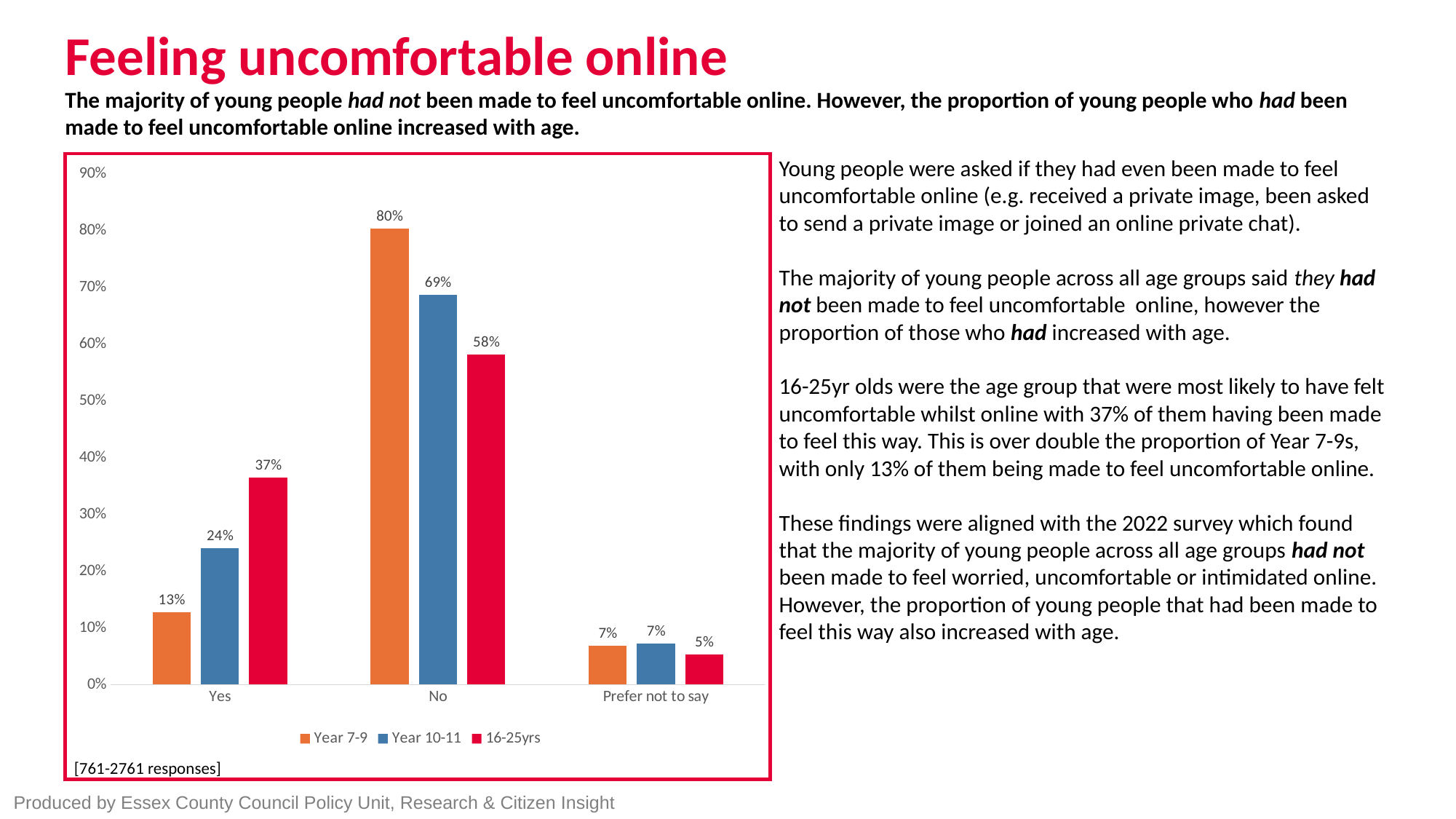
How many series does the legend list? 3 What kind of chart is shown on the slide? Bar chart Which age group has the highest value for 'Yes'? 16-25yrs What percentage of Year 10-11 respondents answered 'Prefer not to say'? 7% What percentage of Year 7-9 respondents answered 'Yes'? 13% Which is larger: the Year 10-11 value for 'No' or the Year 7-9 value for 'No'? Year 7-9 Is the Year 10-11 value for 'Yes' greater or less than 20%? greater Which colour represents the 16-25yrs series in the chart? Red How many response categories are shown on the x axis? 3 What is the difference between the Year 7-9 and 16-25yrs values for 'Yes'? 24% What percentage of 16-25yrs respondents answered 'No'? 58% Which age group has the lowest value for 'No'? 16-25yrs